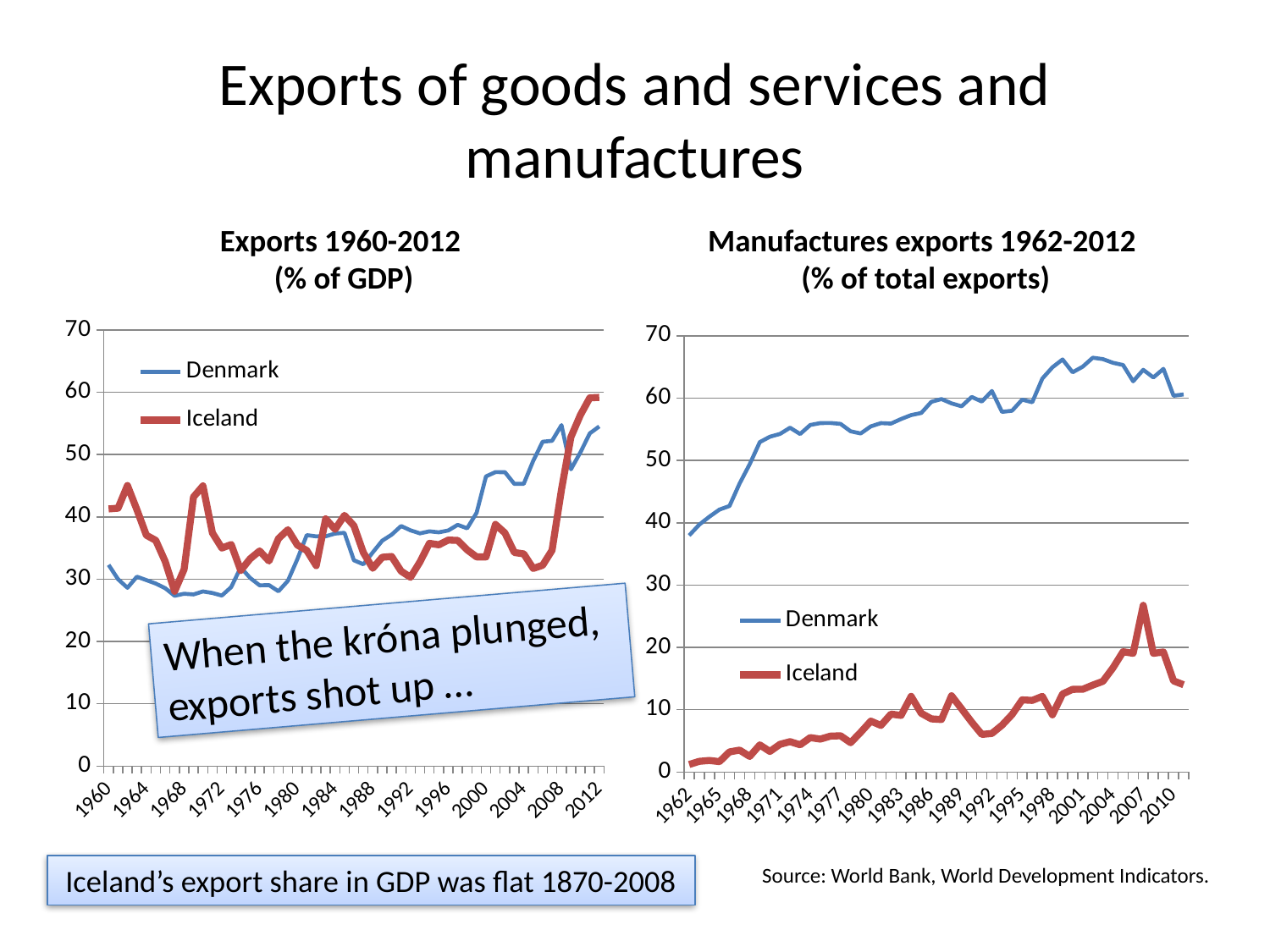
What colour is the Iceland line in the charts on the slide? red What kind of chart is the 'Exports 1960-2012 (% of GDP)' chart on the left? line chart In the 'Exports 1960-2012 (% of GDP)' chart, which two countries are plotted? Denmark and Iceland In the 'Manufactures exports 1962-2012 (% of total exports)' chart, is the value for Iceland in 2007 greater or less than 20? greater In the 'Manufactures exports 1962-2012 (% of total exports)' chart, is the value for Denmark in 1962 greater or less than 40? less How many series does the legend of the 'Manufactures exports 1962-2012' chart on the right list? 2 In the 'Manufactures exports 1962-2012 (% of total exports)' chart, which country has the higher value in 1990, Denmark or Iceland? Denmark In the 'Exports 1960-2012 (% of GDP)' chart, is the value for Iceland in 2012 greater or less than 50? greater In the 'Exports 1960-2012 (% of GDP)' chart, which country has the higher value in 2012, Denmark or Iceland? Iceland In the 'Manufactures exports 1962-2012 (% of total exports)' chart, does the Iceland line overall rise or fall from 1962 to 2012? rise In the 'Exports 1960-2012 (% of GDP)' chart, does the Denmark line overall rise or fall from 1960 to 2012? rise